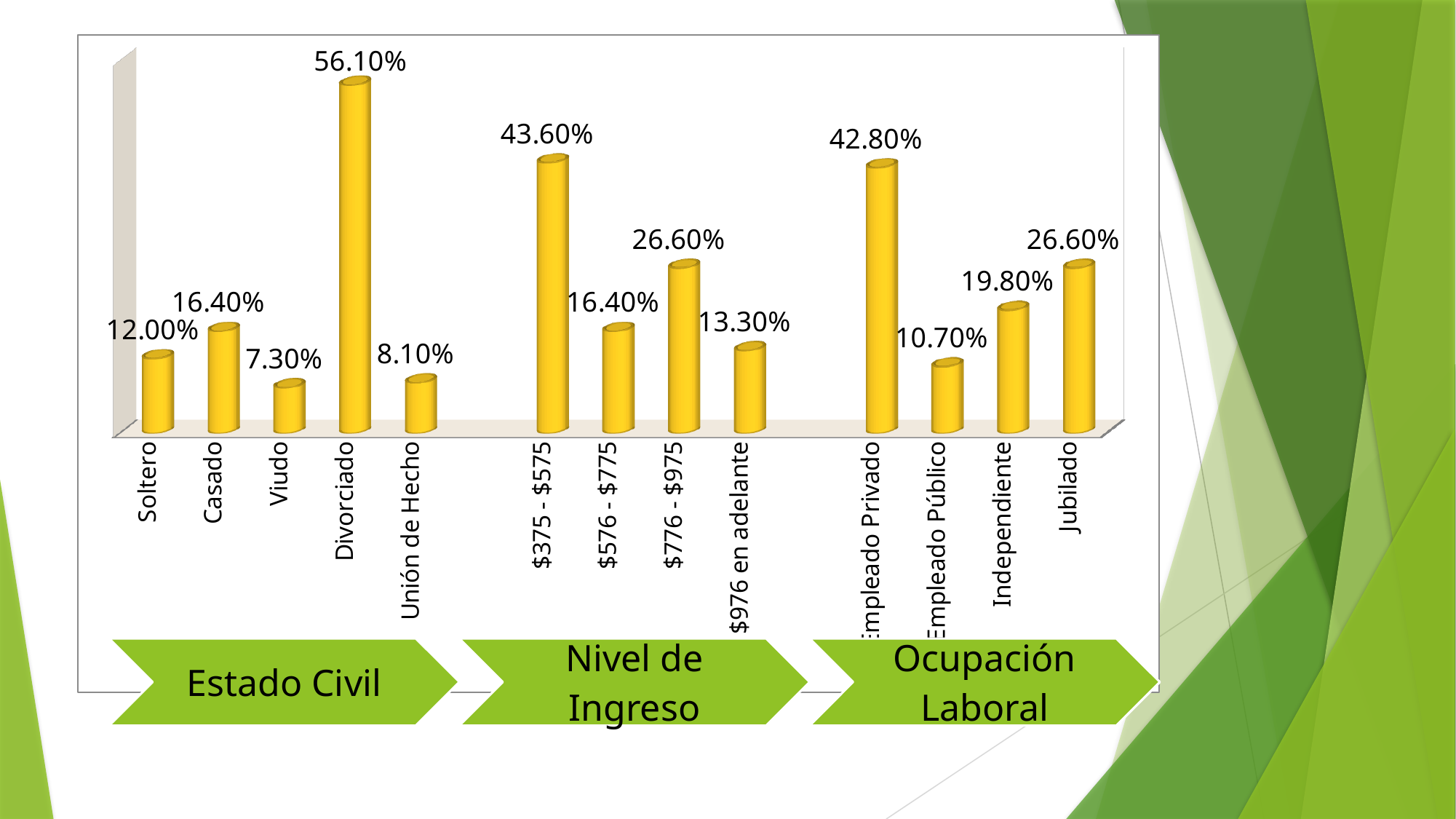
What is the value for Jubilado? 26.60% What is the value for Divorciado? 56.10% Within the Ocupación Laboral group, which category has the highest value? Empleado Privado Which category has the lowest value on the chart? Viudo What is the difference between the values for Divorciado and Casado? 39.70% What is the value for $375 - $575? 43.60% How many bars are plotted on the chart? 13 What is the difference between the values for $375 - $575 and $976 en adelante? 30.30% What kind of chart is shown on the slide? Bar chart What is the value for Empleado Público? 10.70% Which category has the highest value on the chart? Divorciado Which is larger, the value for Independiente or the value for Empleado Público? Independiente